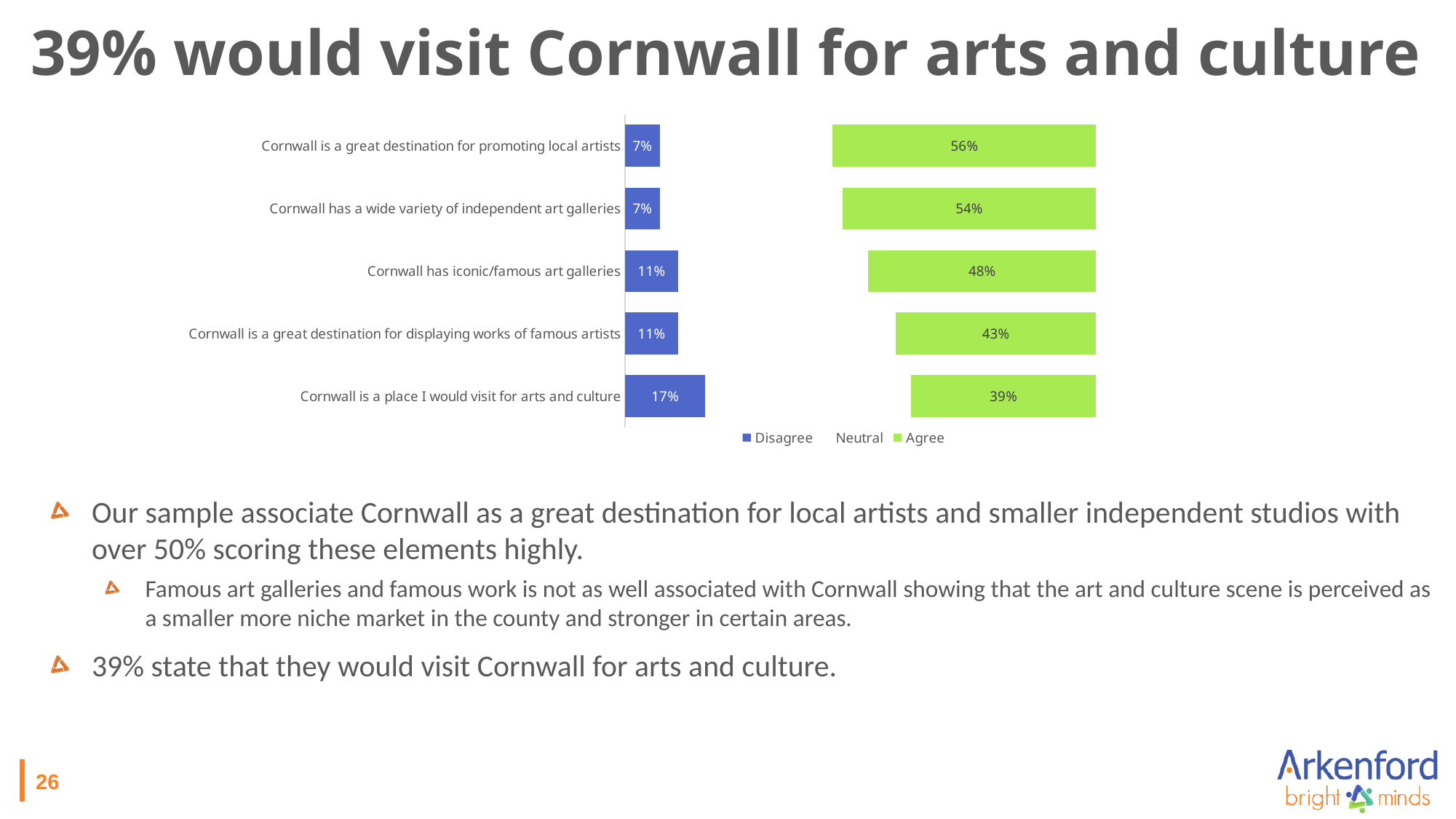
Which statement has the highest Agree percentage? Cornwall is a great destination for promoting local artists Which statement has the highest Disagree percentage? Cornwall is a place I would visit for arts and culture What percentage disagree that Cornwall is a place they would visit for arts and culture? 17% Which has a larger Agree percentage: 'Cornwall has iconic/famous art galleries' or 'Cornwall is a great destination for displaying works of famous artists'? Cornwall has iconic/famous art galleries What is the difference between the Agree percentages for 'Cornwall is a great destination for promoting local artists' and 'Cornwall is a place I would visit for arts and culture'? 17% What is the Disagree value for 'Cornwall has a wide variety of independent art galleries'? 7% What type of chart is shown on the slide? Stacked bar chart How many series does the legend list? 3 Which statement has the lowest Agree percentage? Cornwall is a place I would visit for arts and culture What percentage agree that Cornwall is a great destination for promoting local artists? 56% What is the Agree value for 'Cornwall has iconic/famous art galleries'? 48% How many statements are shown in the chart? 5